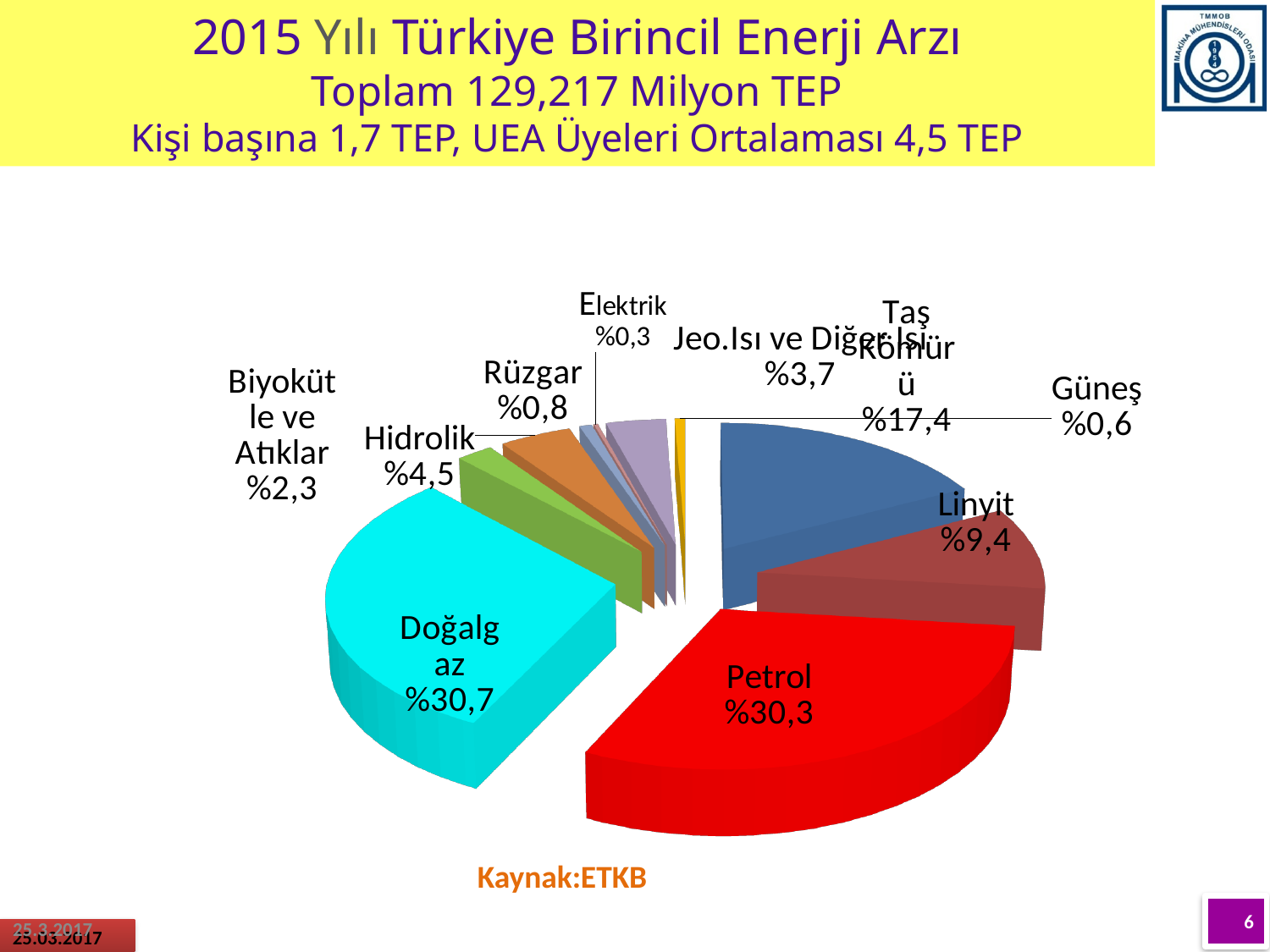
What is the value shown for Hidrolik? %4,5 How many categories are shown in the pie chart? 10 What kind of chart is shown on the slide? Pie chart Which category has the largest slice of the pie? Doğalgaz What is the value shown for Jeo.Isı ve Diğer Isı? %3,7 What source is cited below the chart? Kaynak:ETKB What is the difference between the shares of Taş Kömürü and Linyit? %8,0 What share of the pie does Petrol have? %30,3 What is the value shown for Taş Kömürü? %17,4 Which is larger, the share for Taş Kömürü or the share for Linyit? Taş Kömürü Which category has the smallest slice of the pie? Elektrik What share of the pie does Doğalgaz have? %30,7